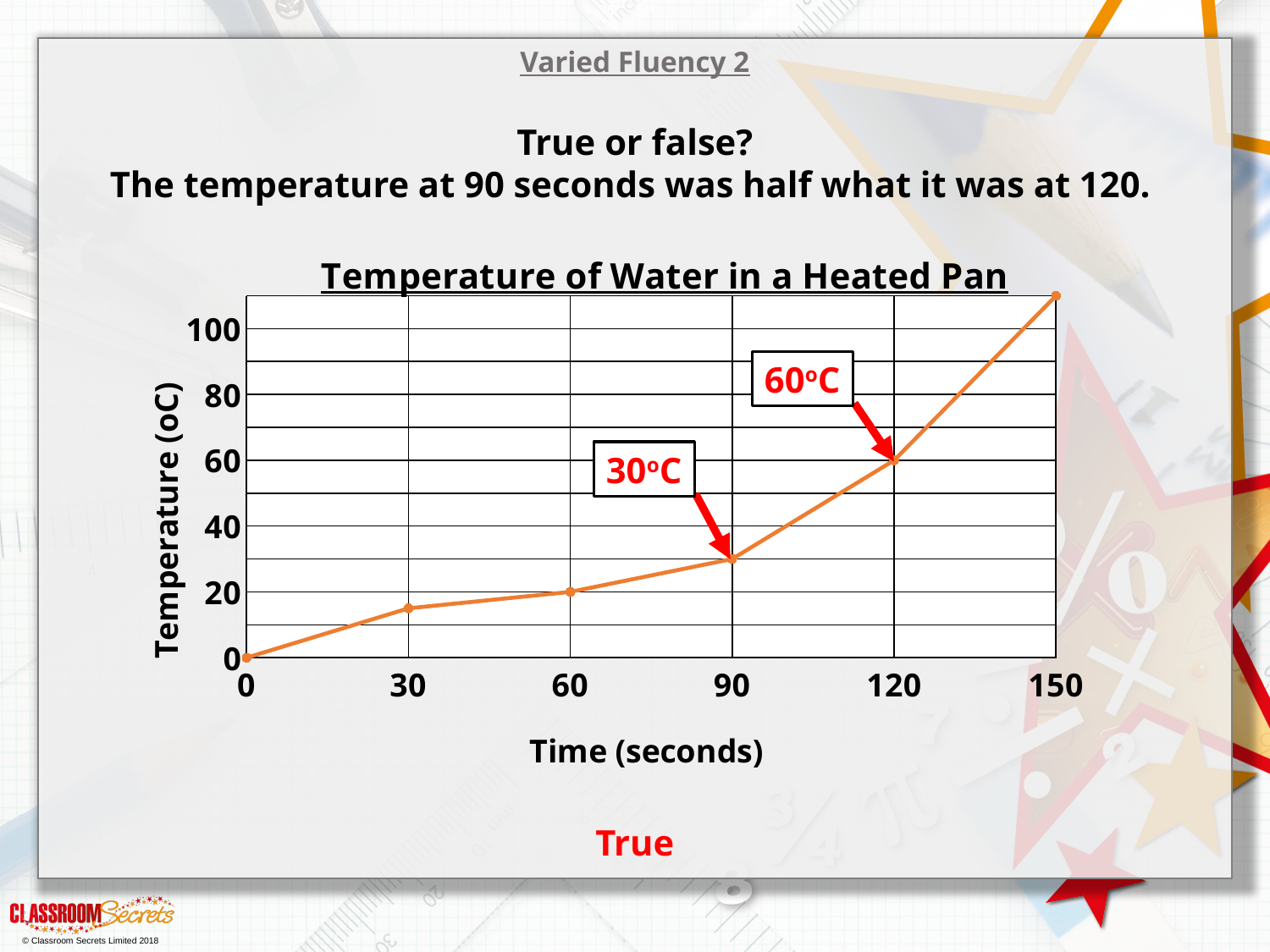
What was the temperature at 60 seconds? 20 Is the temperature at 30 seconds greater or less than 20? less How many data points are plotted on the line? 6 Does the temperature rise or fall as time increases? Rise What kind of chart is shown on the slide? Line chart What was the temperature of the water at 120 seconds? 60°C What was the temperature at 0 seconds? 0 At which time is the temperature highest? 150 seconds Is the temperature at 150 seconds greater or less than 100? greater How much higher was the temperature at 120 seconds than at 90 seconds? 30°C What was the temperature of the water at 90 seconds? 30°C Which time had the higher temperature, 90 seconds or 120 seconds? 120 seconds